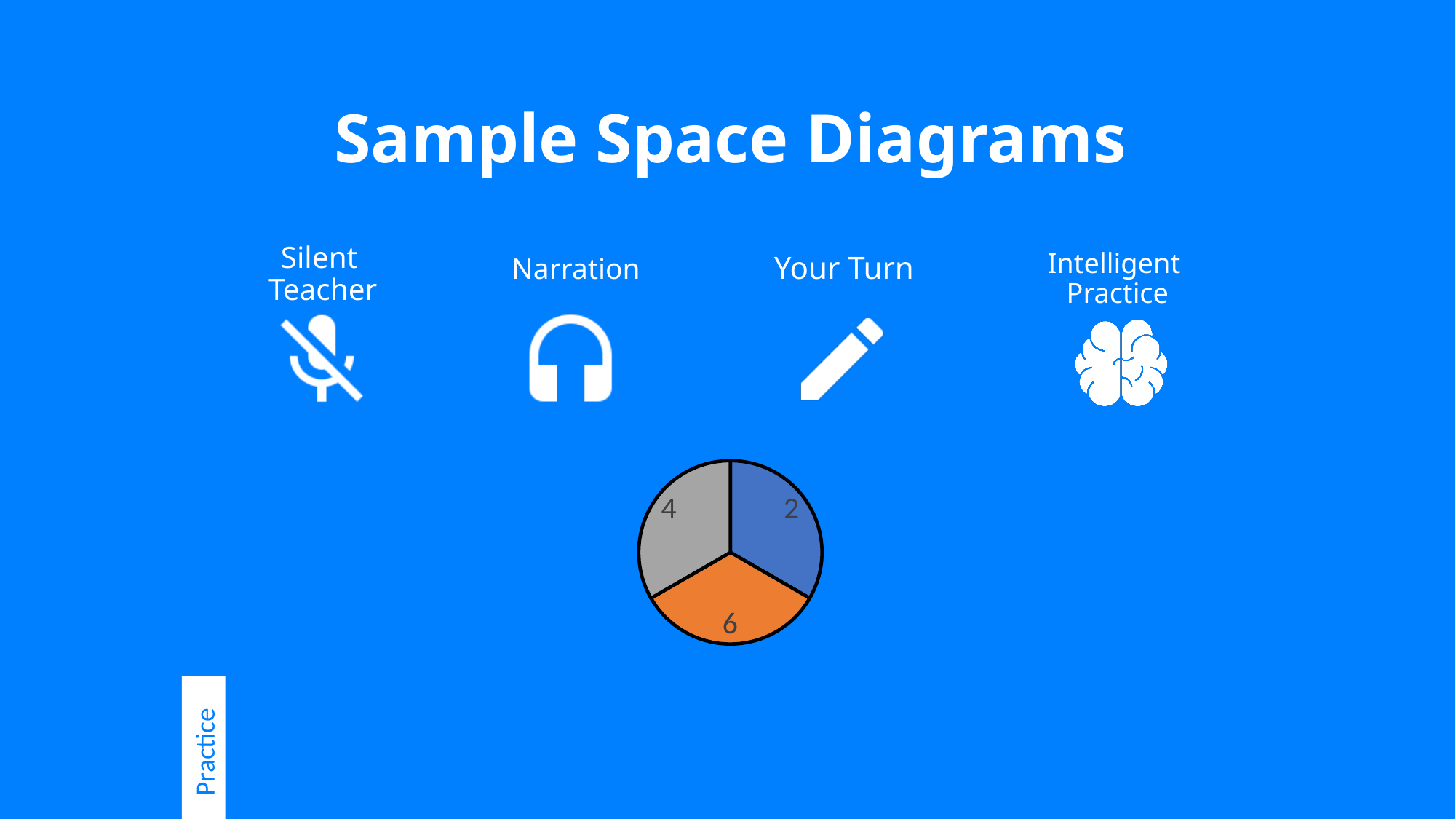
What number labels the orange sector of the pie chart? 6 What kind of chart is shown on the slide? pie chart Which numbers appear as labels on the pie chart's sectors? 4, 2 and 6 What number labels the grey sector of the pie chart? 4 What colour is the sector labelled 6 in the pie chart? orange What colour is the sector labelled 2 in the pie chart? blue How many sectors does the pie chart have? 3 What number labels the blue sector of the pie chart? 2 Are the three sectors of the pie chart roughly equal in size? yes